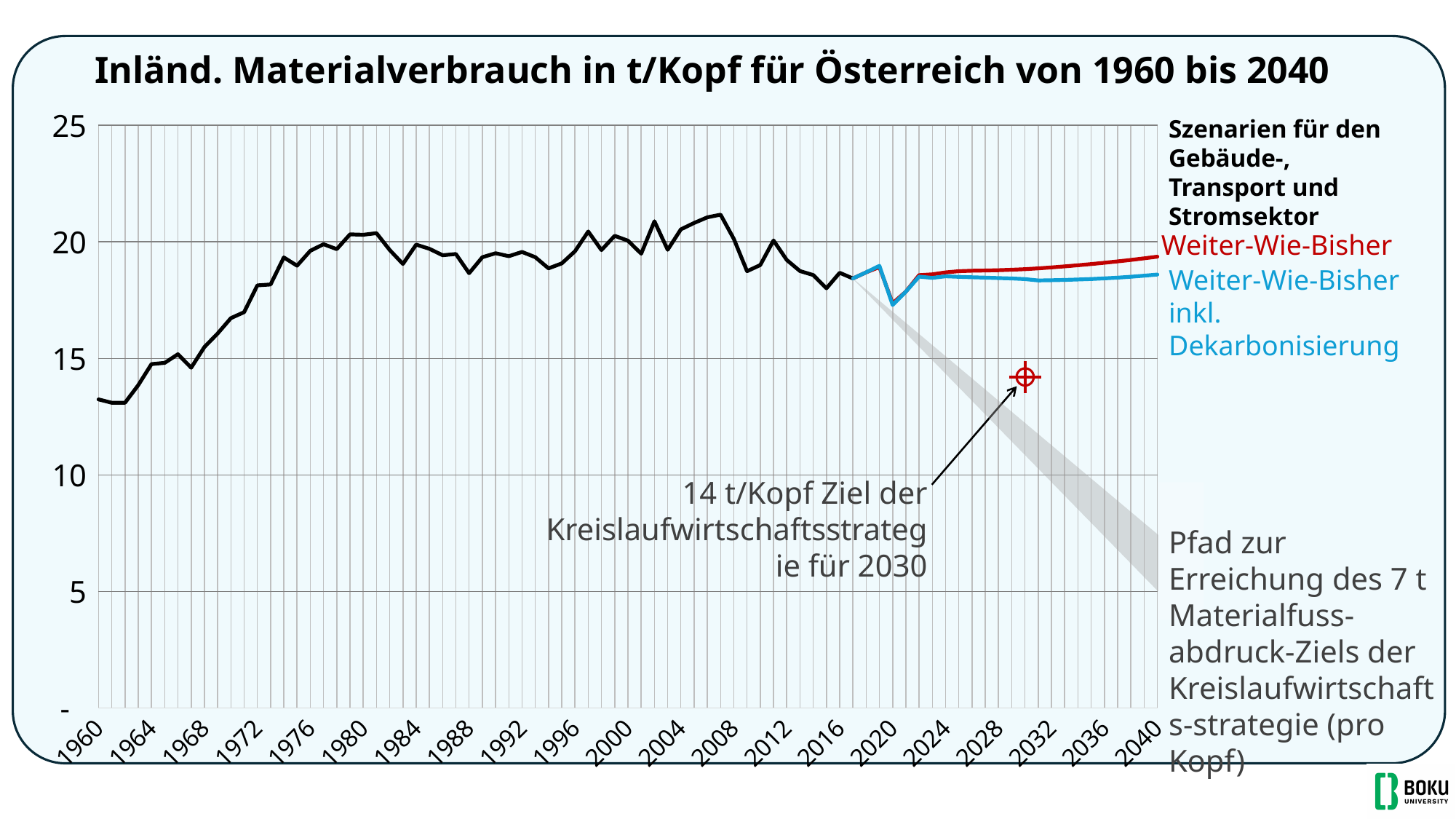
How many scenario lines are labelled to the right of the chart (Weiter-Wie-Bisher variants)? 2 Is the value for 1980 greater or less than 20? greater Is the value for 1960 greater or less than 15? less Is the value of the Weiter-Wie-Bisher scenario in 2040 greater or less than 20? less What kind of chart is shown on the slide? line chart What material footprint target (per capita) does the grey path lead to, according to the annotation? 7 t Does the value rise or fall between 2008 and 2016? fall In 2040, which scenario line is higher: Weiter-Wie-Bisher or Weiter-Wie-Bisher inkl. Dekarbonisierung? Weiter-Wie-Bisher What target value for 2030 is annotated on the chart? 14 t/Kopf Does the value rise or fall between 1960 and 1980? rise What is the title of the chart? Inländ. Materialverbrauch in t/Kopf für Österreich von 1960 bis 2040